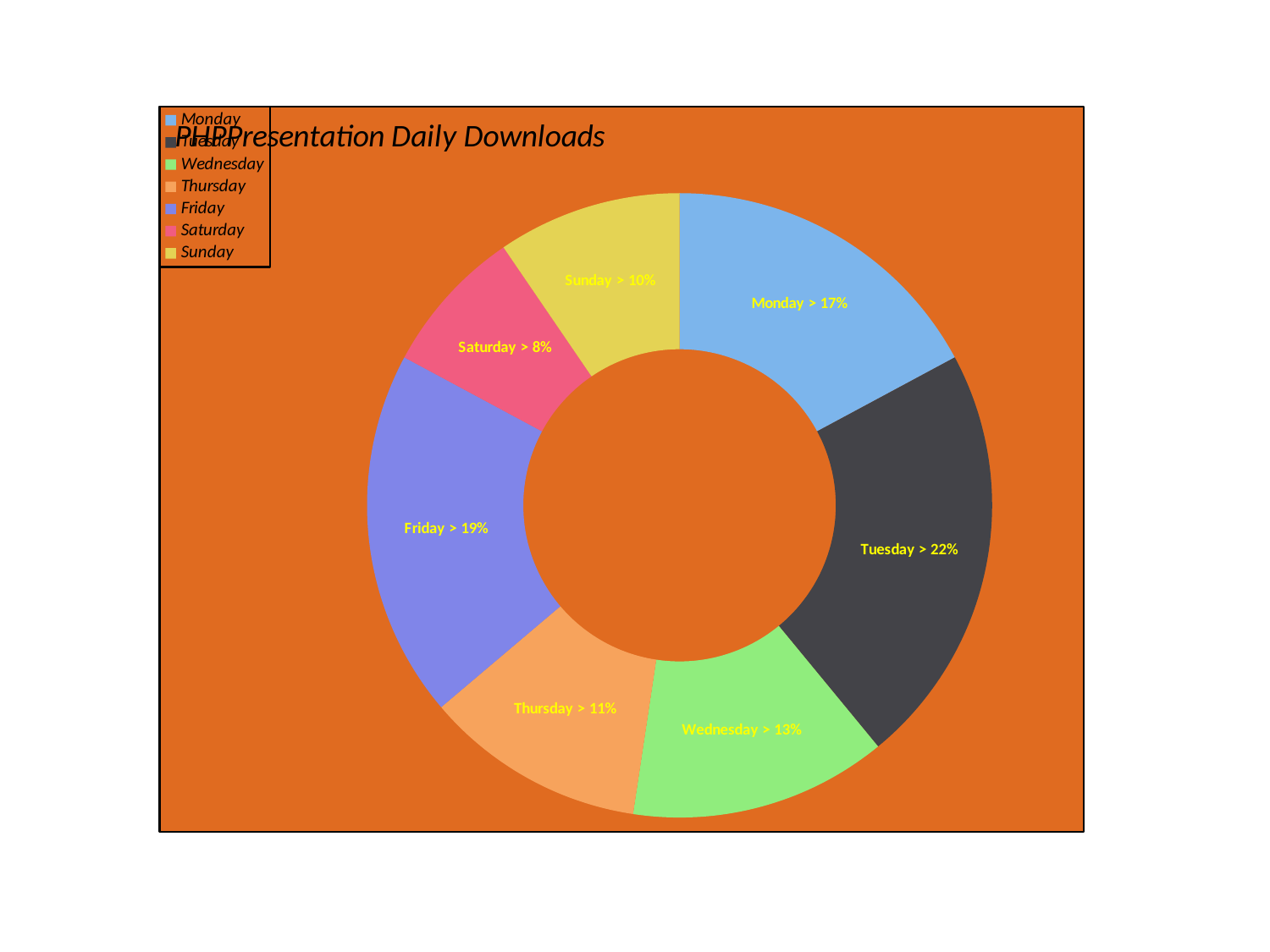
What share of daily downloads does Tuesday account for? 22% What is the title of the chart? PHPPresentation Daily Downloads What colour is the Friday segment? Purple/blue How many days are shown in the chart? 7 What share of daily downloads does Friday account for? 19% What is the difference in percentage points between Tuesday's and Monday's shares? 5 What share of daily downloads does Saturday account for? 8% Which has a larger share, Thursday or Sunday? Thursday What kind of chart is shown on the slide? Doughnut (pie) chart Which day has the smallest share of downloads? Saturday What share of daily downloads does Wednesday account for? 13% Which day has the largest share of downloads? Tuesday